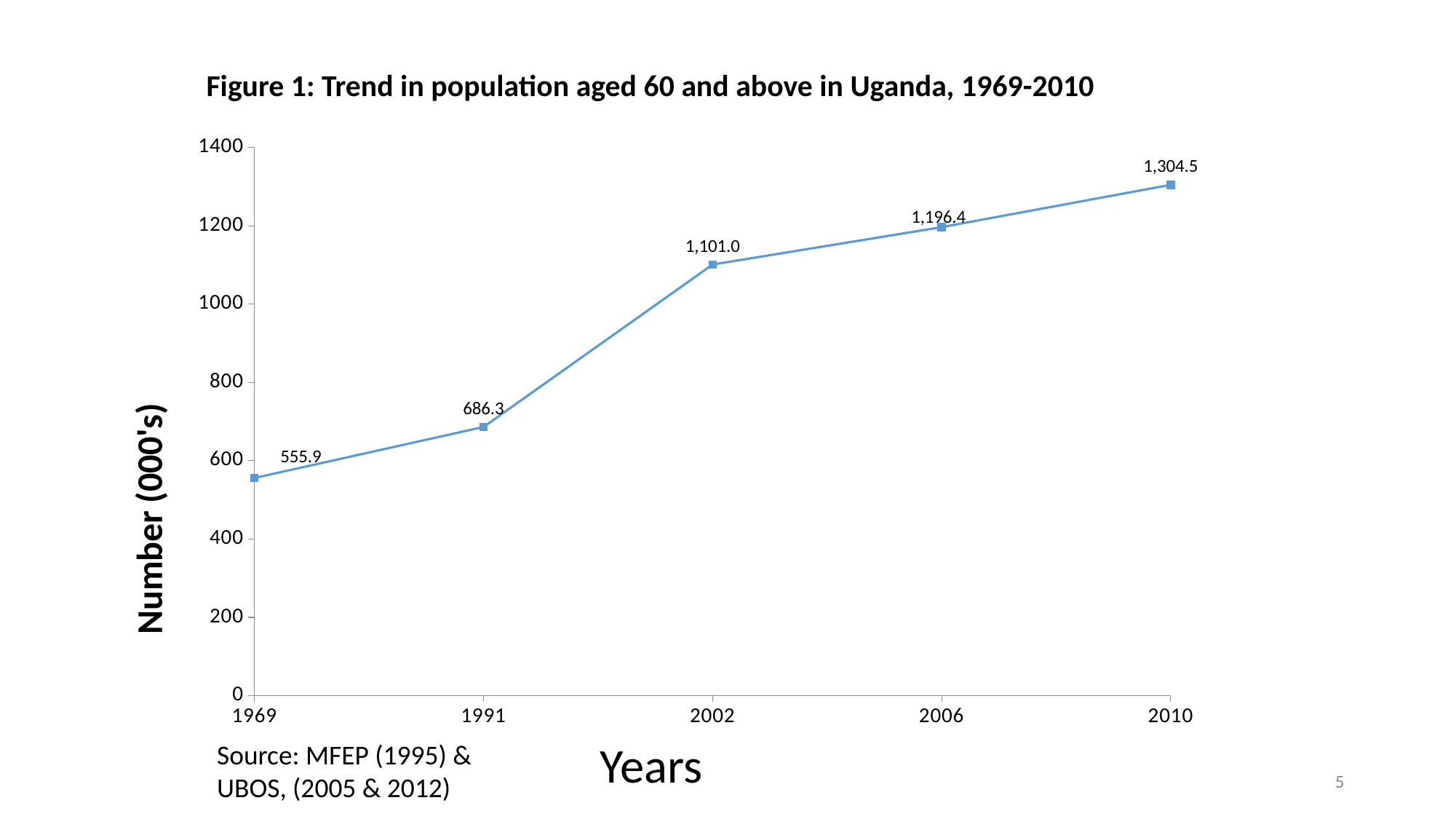
Which year has the highest value? 2010 What kind of chart is shown on the slide? line chart What is the difference between the values for 2010 and 2006? 108.1 What is the value for 2002? 1,101.0 How many data points are plotted on the chart? 5 What is the value for 2010? 1,304.5 Which year has the lowest value? 1969 Do the values rise or fall from 1969 to 2010? rise Is the value for 1991 greater or less than 800? less What is the value for 1969? 555.9 Which is larger, the value for 1991 or the value for 2006? 2006 What is the difference between the values for 2002 and 1991? 414.7